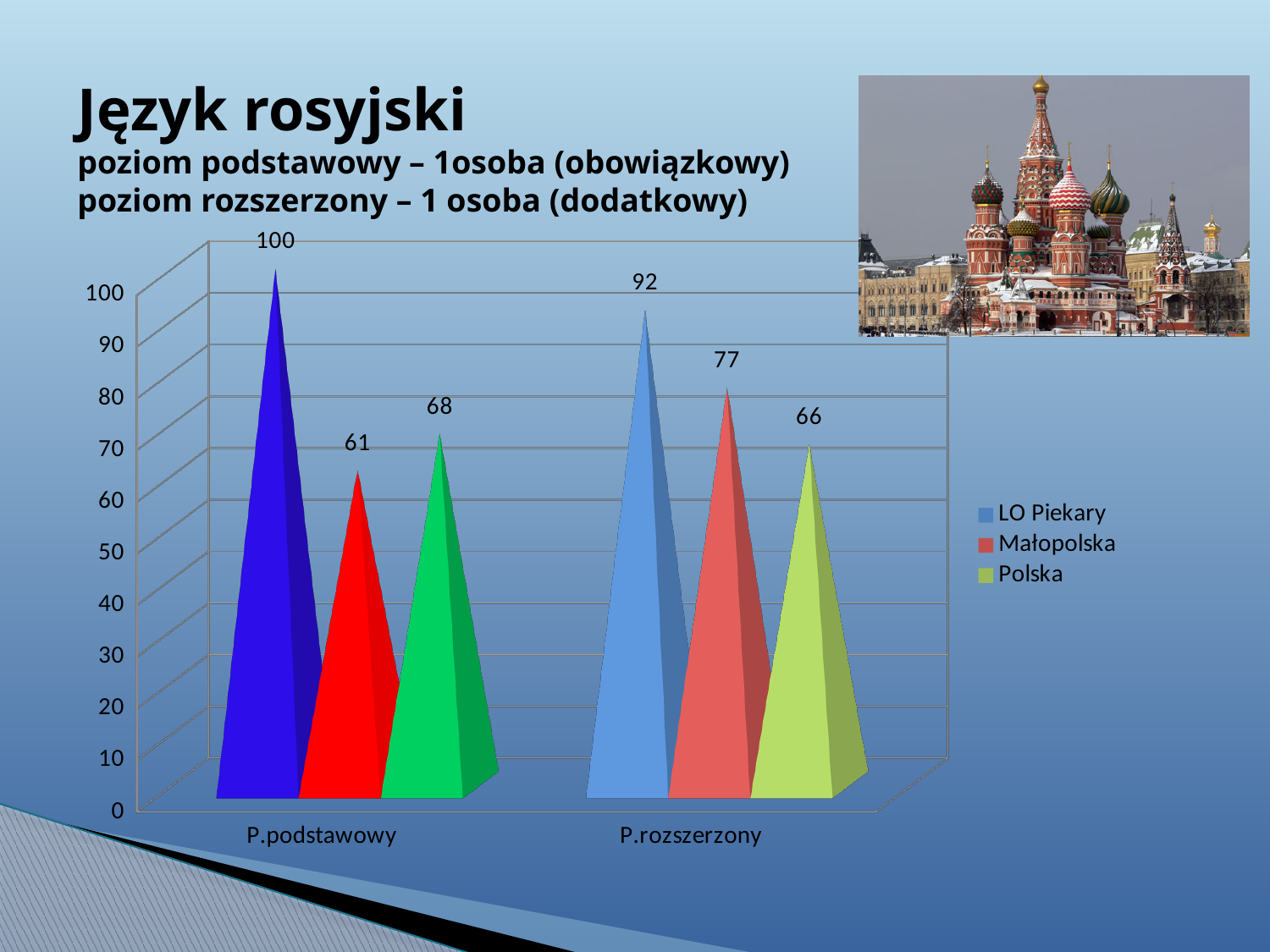
What is the difference between the Małopolska and Polska values at P.rozszerzony? 11 Which series has the lowest value at P.podstawowy? Małopolska How many series does the legend list? 3 What is the value for Polska at P.podstawowy? 68 Which is larger: the Małopolska value at P.podstawowy or the Małopolska value at P.rozszerzony? P.rozszerzony How many categories are shown on the x axis? 2 What kind of chart is shown on the slide? bar chart What is the value for LO Piekary at P.podstawowy? 100 What is the value for LO Piekary at P.rozszerzony? 92 What is the difference between the LO Piekary and Polska values at P.podstawowy? 32 What is the value for Małopolska at P.rozszerzony? 77 Which series has the highest value at P.rozszerzony? LO Piekary